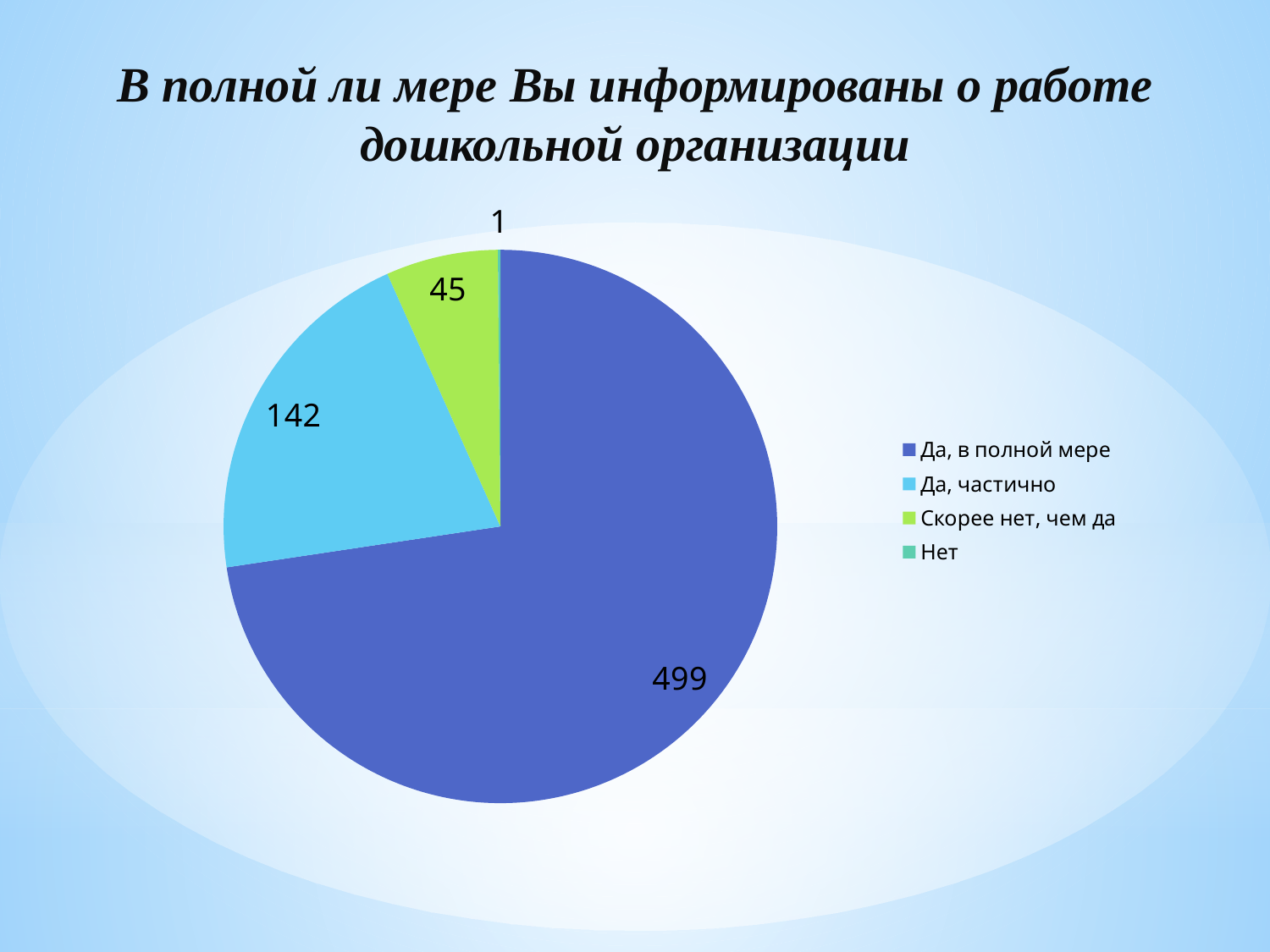
What is the value for "Да, частично"? 142 Which category has the smallest slice of the pie? Нет What kind of chart is shown on the slide? pie chart What colour is the slice for "Скорее нет, чем да"? green Which is larger, the value for "Да, частично" or the value for "Скорее нет, чем да"? Да, частично How many categories does the legend list? 4 What is the difference between the values for "Да, в полной мере" and "Да, частично"? 357 What is the value for "Да, в полной мере"? 499 Which category has the largest slice of the pie? Да, в полной мере What is the value for "Скорее нет, чем да"? 45 What is the value for "Нет"? 1 What is the total of all the values shown on the pie chart? 687